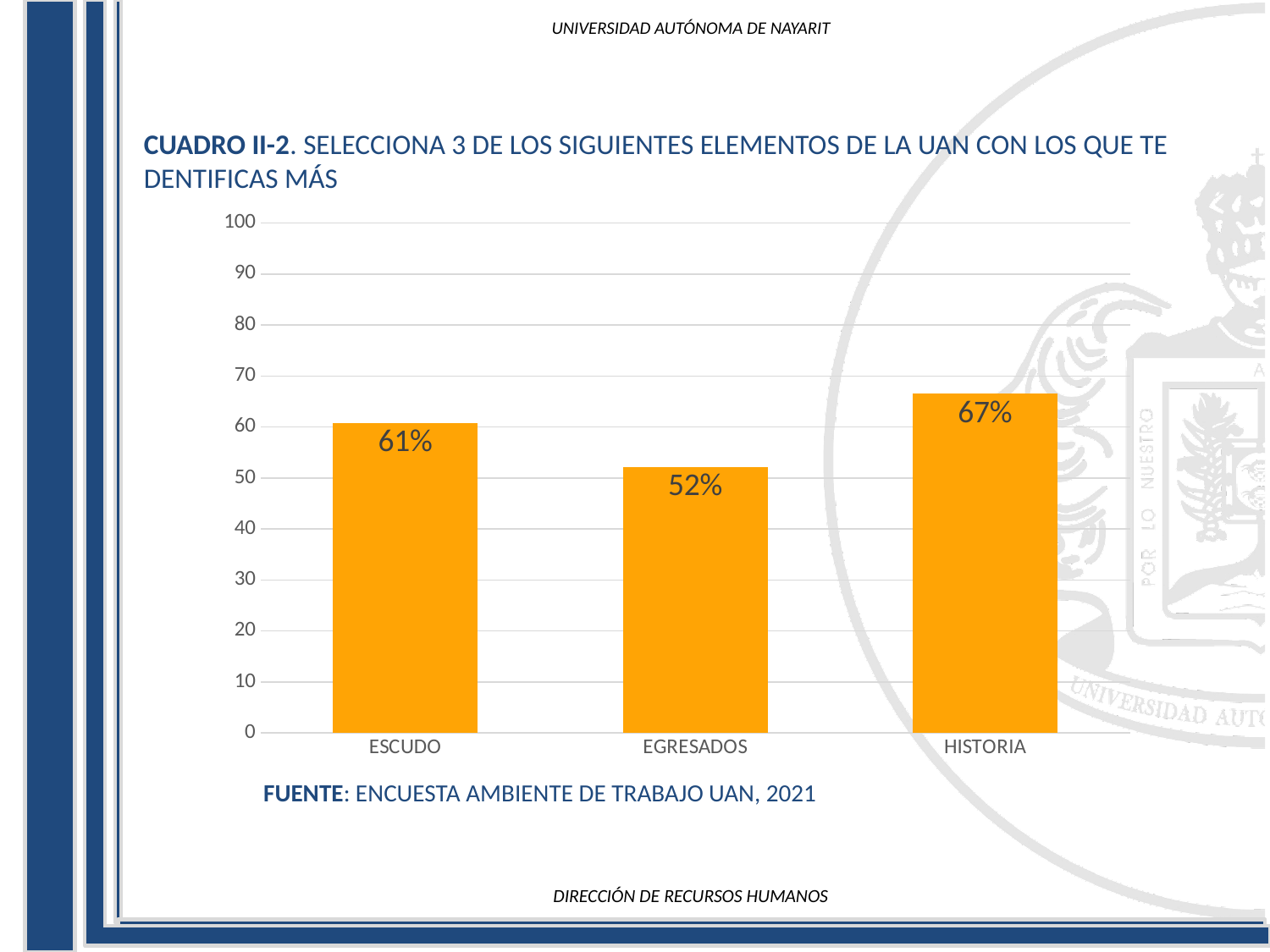
What kind of chart is shown on the slide? bar chart What is the value for ESCUDO? 61% What is the difference between the values for HISTORIA and EGRESADOS? 15% Which category has the lowest value? EGRESADOS How many categories are shown on the x axis? 3 Which is larger, the value for ESCUDO or the value for HISTORIA? HISTORIA What is the difference between the values for ESCUDO and EGRESADOS? 9% Is the value for EGRESADOS greater or less than 60? less What source is cited below the chart? ENCUESTA AMBIENTE DE TRABAJO UAN, 2021 What is the value for EGRESADOS? 52% Which category has the highest value? HISTORIA What is the value for HISTORIA? 67%